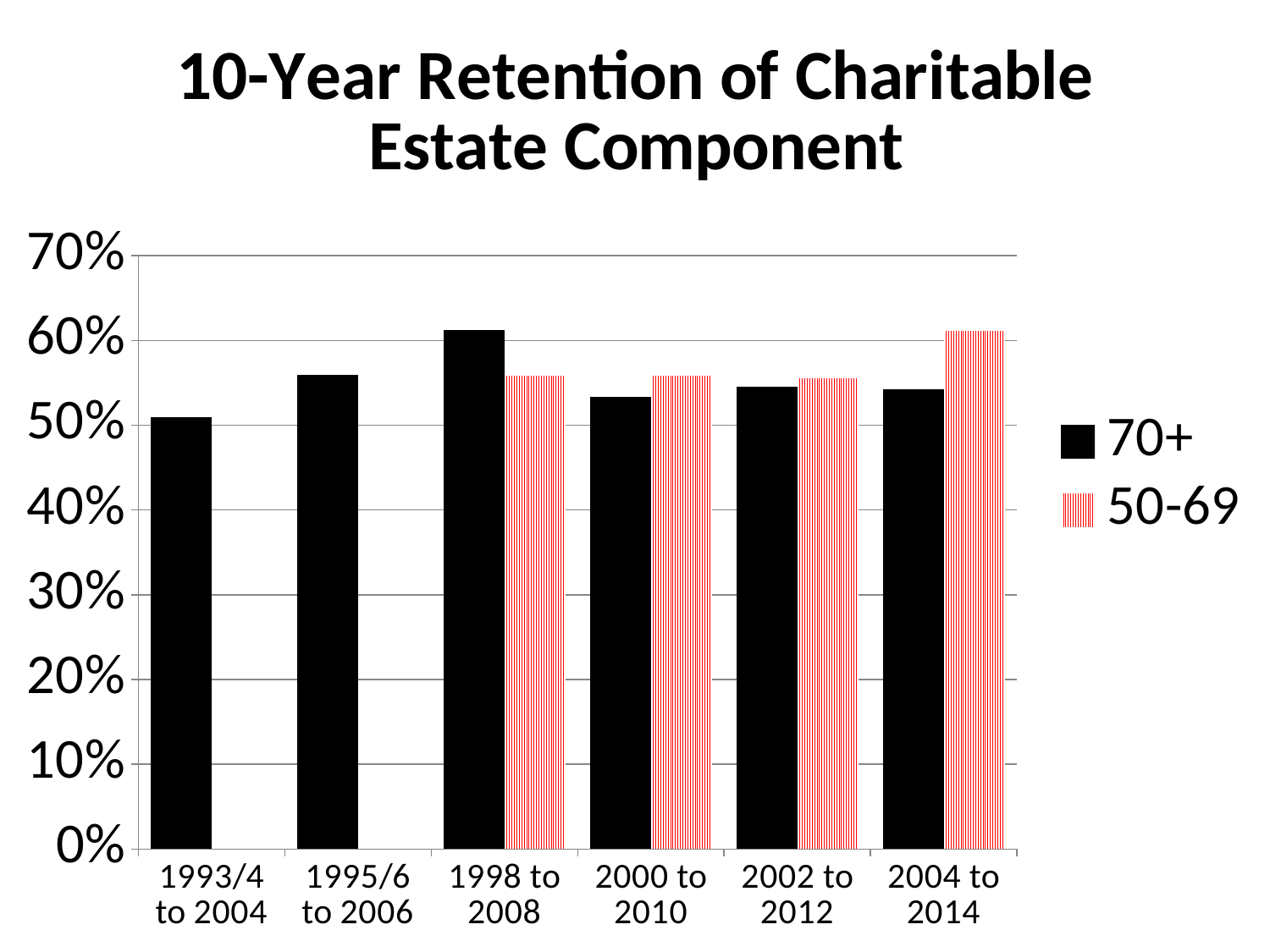
Is the value for 50-69 in 2004 to 2014 greater or less than 50%? greater What kind of chart is shown on the slide? bar chart How many series does the legend list? 2 In 2004 to 2014, which series has the larger value, 70+ or 50-69? 50-69 Is the value for 70+ in 1993/4 to 2004 greater or less than 60%? less Which period has the lowest value for the 70+ series? 1993/4 to 2004 In 1998 to 2008, which series has the larger value, 70+ or 50-69? 70+ What is the title of the chart? 10-Year Retention of Charitable Estate Component Which period has the highest value for the 70+ series? 1998 to 2008 Which period has the highest value for the 50-69 series? 2004 to 2014 Is the value for 70+ in 1998 to 2008 greater or less than 50%? greater How many time-period categories are shown on the x axis? 6